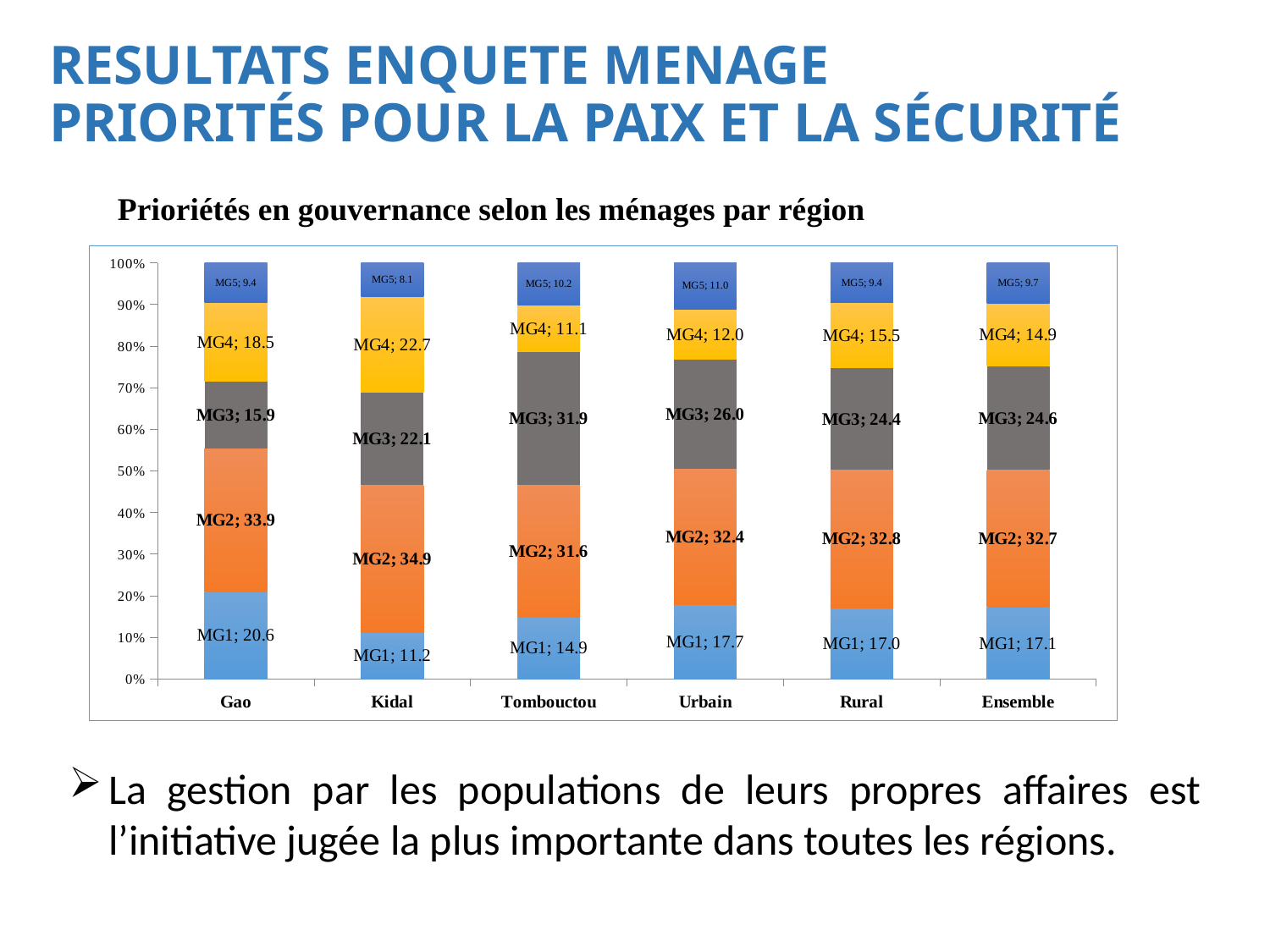
What is the value of MG1 for Gao? 20.6 What is the value of MG3 for Tombouctou? 31.9 What is the title of the chart? Prioriétés en gouvernance selon les ménages par région What is the value of MG4 for Ensemble? 14.9 How many regions/categories are shown on the x axis? 6 What is the value of MG2 for Kidal? 34.9 Which is larger for Rural: MG3 or MG4? MG3 Which region has the highest MG2 value? Kidal What type of chart is shown on the slide? Stacked bar chart Which region has the lowest MG1 value? Kidal What is the difference between the MG2 and MG1 values for Gao? 13.3 What is the value of MG5 for Urbain? 11.0